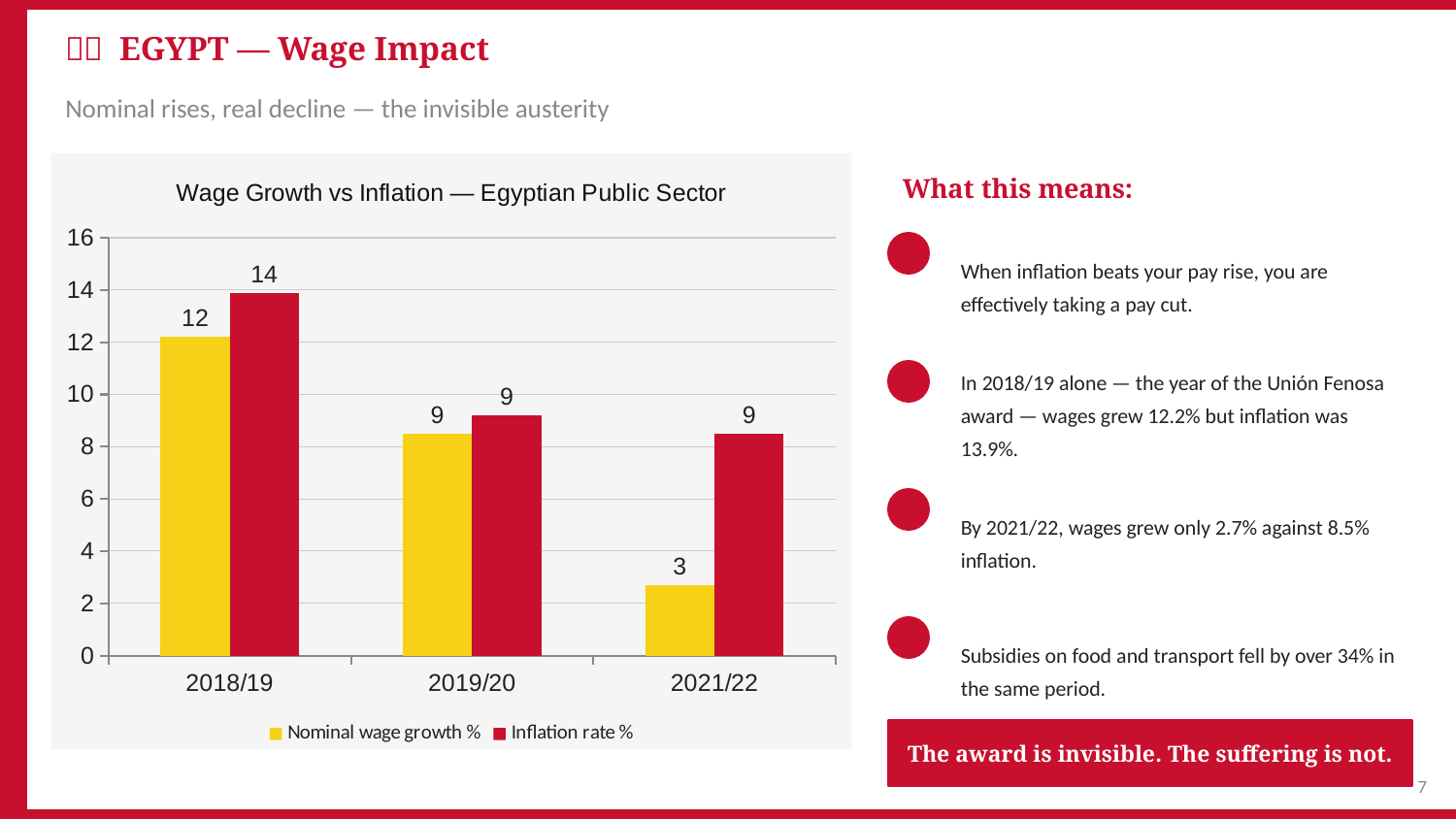
Using the data labels, what is the difference between the inflation rate % and nominal wage growth % in 2021/22? 6 What type of chart is shown on the slide? Bar chart Which year has the highest inflation rate %? 2018/19 What is the title of the chart? Wage Growth vs Inflation — Egyptian Public Sector Which year has the lowest nominal wage growth %? 2021/22 How many series does the chart legend list? 2 Does nominal wage growth % rise or fall across the years from 2018/19 to 2021/22? Fall In 2021/22, which is larger: nominal wage growth % or inflation rate %? Inflation rate % Which year has the highest nominal wage growth %? 2018/19 What is the inflation rate % value labelled for 2021/22? 9 What is the nominal wage growth % value labelled for 2018/19? 12 How many fiscal years are shown on the x axis of the chart? 3